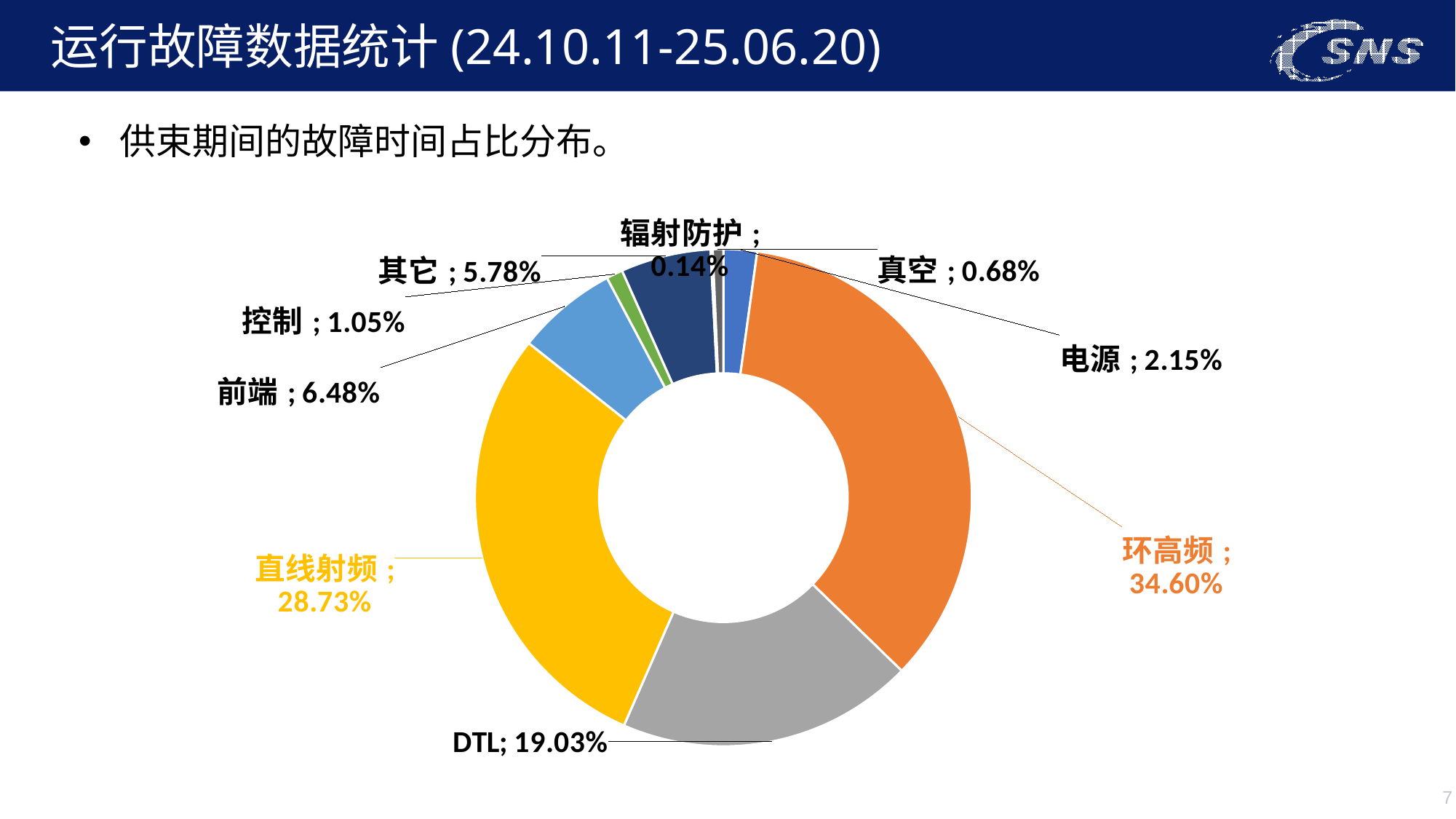
What share of fault time does 环高频 account for? 34.60% Which category has the largest share of fault time? 环高频 How many categories are shown in the chart? 9 What percentage is shown for 电源? 2.15% What kind of chart is shown on the slide? Doughnut (pie) chart What is the difference between the shares of 环高频 and 直线射频? 5.87% What colour is the 直线射频 slice? Yellow What percentage is shown for 直线射频? 28.73% What is the value shown for DTL? 19.03% Which is larger, the share for 其它 or the share for 前端? 前端 Which category has the smallest share of fault time? 辐射防护 What is the value for 前端? 6.48%